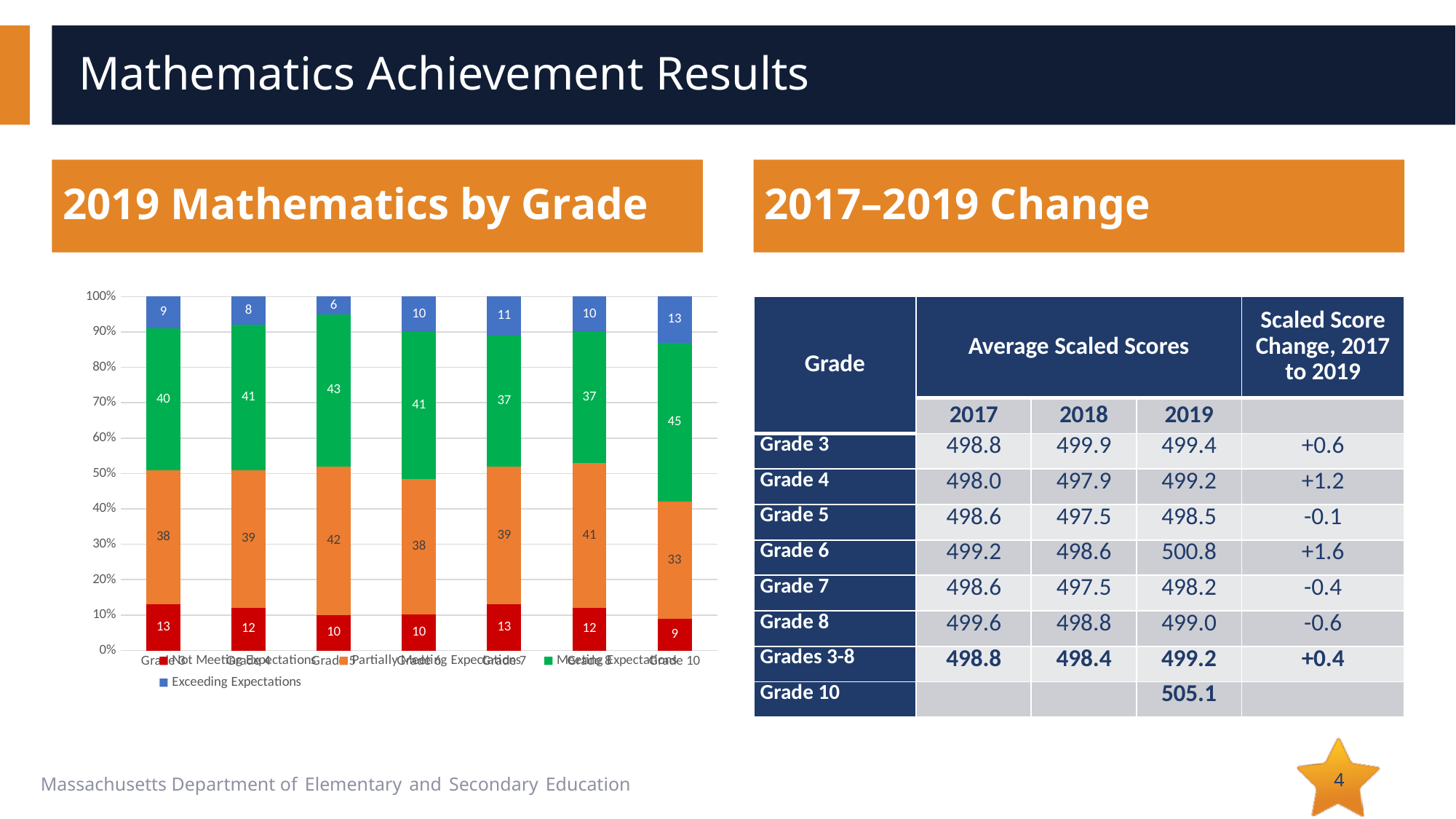
How many series does the legend of the 2019 Mathematics by Grade chart list? 4 In the 2019 Mathematics by Grade chart, which bar has the lowest Partially Meeting Expectations (orange) value? Grade 10 In the 2019 Mathematics by Grade chart, what is the lowest Exceeding Expectations (blue) value shown? 6 How many bars (grades) are plotted in the 2019 Mathematics by Grade chart? 7 In the 2019 Mathematics by Grade chart, which colour represents Meeting Expectations? Green In the 2019 Mathematics by Grade chart, what is the Exceeding Expectations value for Grade 10 (the rightmost bar)? 13 In the 2019 Mathematics by Grade chart, is the Not Meeting Expectations value larger for the first bar (Grade 3) or the last bar (Grade 10)? Grade 3 In the 2019 Mathematics by Grade chart, what is the difference between the Meeting Expectations and Partially Meeting Expectations values for Grade 10? 12 In the 2019 Mathematics by Grade chart, what is the Partially Meeting Expectations value for the third bar (Grade 5)? 42 In the 2019 Mathematics by Grade chart, what is the Meeting Expectations value for the first bar (Grade 3)? 40 In the 2019 Mathematics by Grade chart, which bar has the highest Meeting Expectations (green) value? Grade 10 What kind of chart is shown under the heading '2019 Mathematics by Grade'? Stacked bar chart